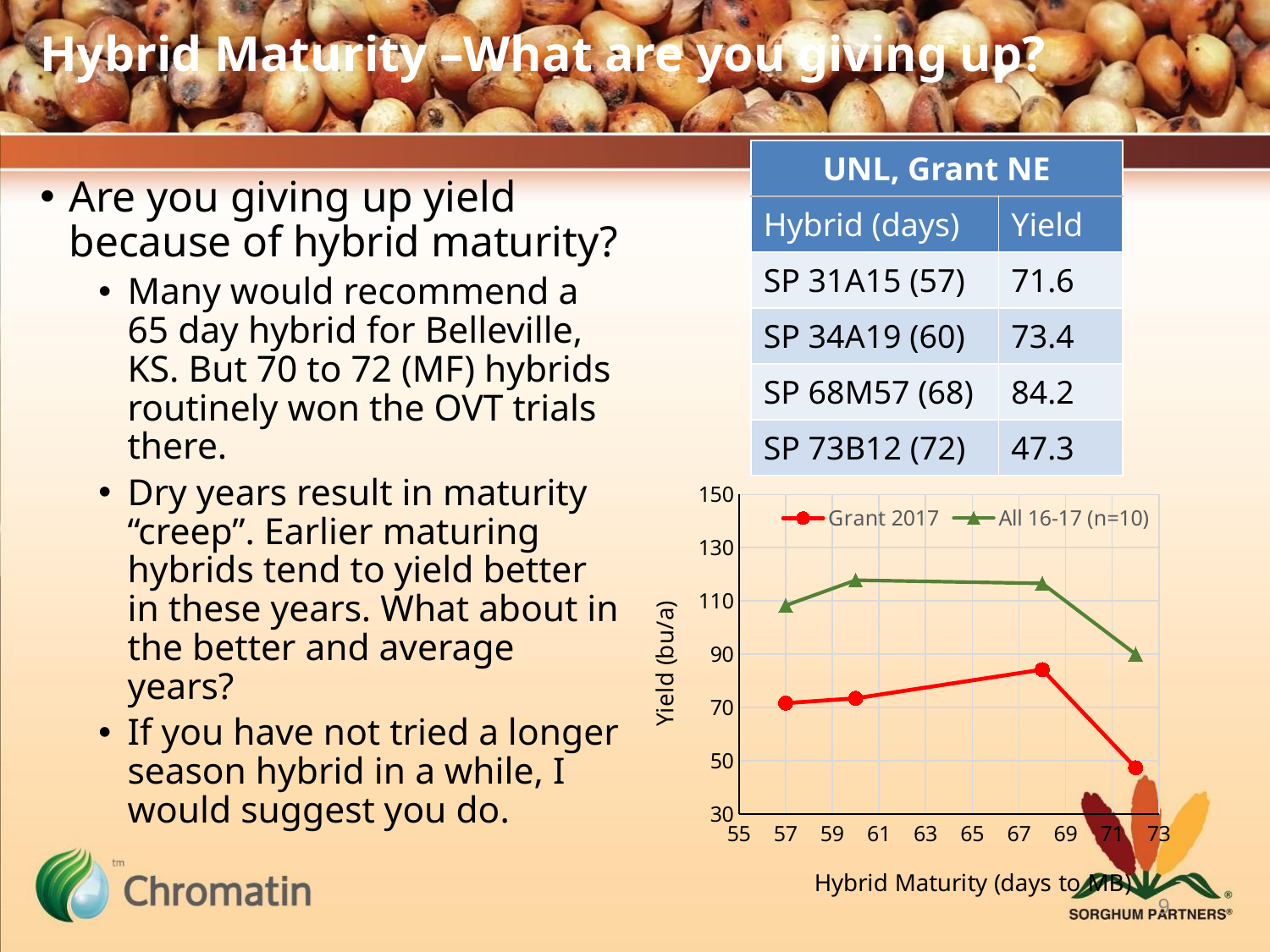
According to the slide, what is the Grant 2017 yield for the 72-day hybrid SP 73B12? 47.3 Is the All 16-17 (n=10) yield at 60 days maturity greater or less than 110? greater According to the slide, what is the Grant 2017 yield for the 68-day hybrid SP 68M57? 84.2 At 57 days maturity, which series has the higher yield, Grant 2017 or All 16-17 (n=10)? All 16-17 (n=10) What kind of chart is shown on the slide? line chart At which hybrid maturity does the All 16-17 (n=10) series have its lowest yield? 72 What is the difference between the Grant 2017 yields of the 68-day hybrid (84.2) and the 72-day hybrid (47.3)? 36.9 How many series does the chart legend list? 2 What is the label of the chart's y axis? Yield (bu/a) What are the two series named in the chart legend? Grant 2017 and All 16-17 (n=10) How many data points are plotted for the Grant 2017 series? 4 At which hybrid maturity does the Grant 2017 series reach its highest yield? 68